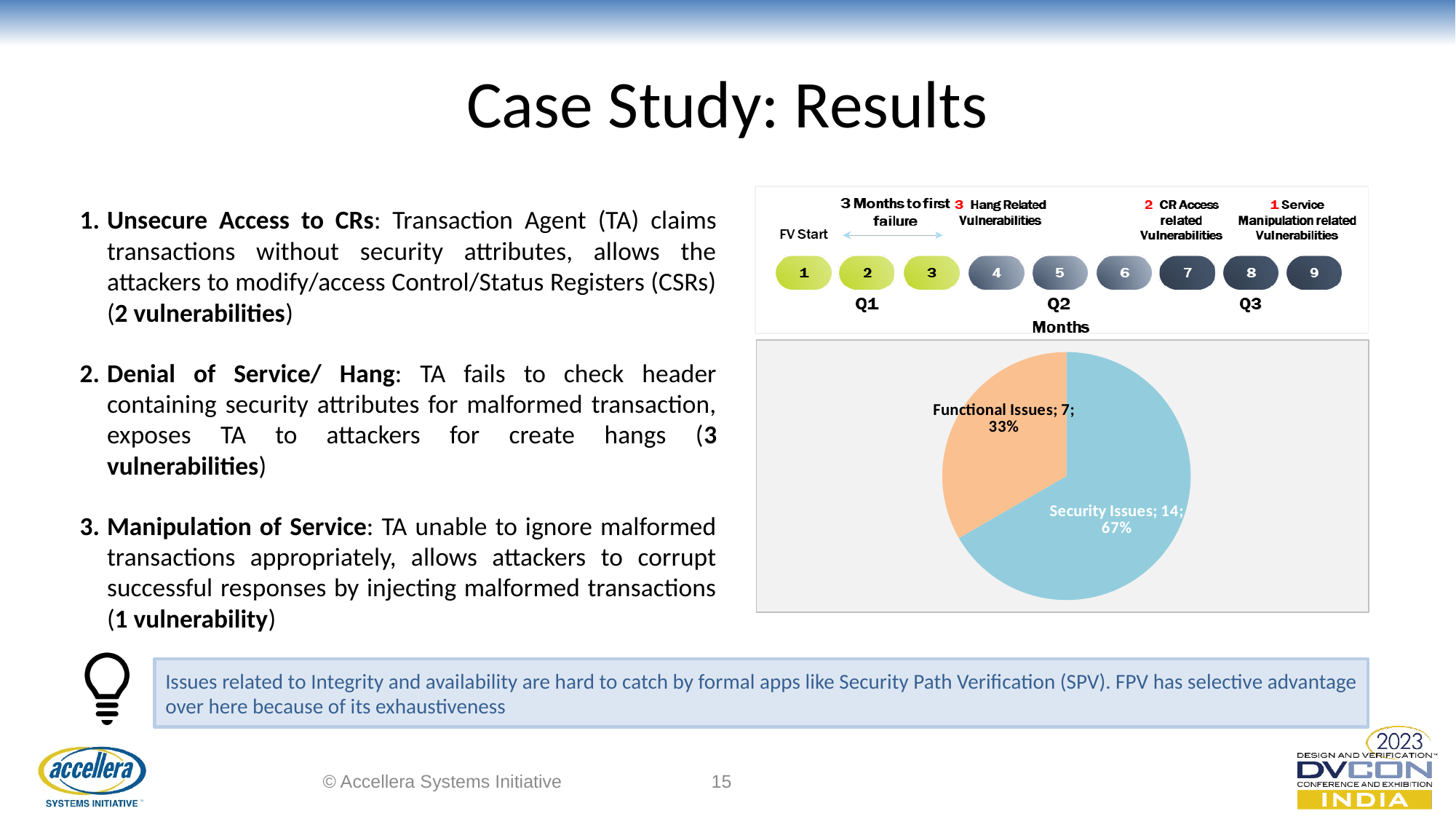
In the pie chart, what share of the pie do Functional Issues represent? 33% In the pie chart, what share of the pie do Security Issues represent? 67% In the pie chart, what is the difference between the Security Issues value and the Functional Issues value? 7 What kind of chart is shown on the right side of the slide below the timeline? pie chart In the pie chart, which is larger: Security Issues or Functional Issues? Security Issues In the pie chart, what is the value for Functional Issues? 7 Which slice of the pie chart is the smallest? Functional Issues How many slices does the pie chart have? 2 What colour is the Security Issues slice in the pie chart? blue Which slice of the pie chart is the largest? Security Issues In the pie chart, what is the value for Security Issues? 14 What is the total of the two values shown in the pie chart? 21